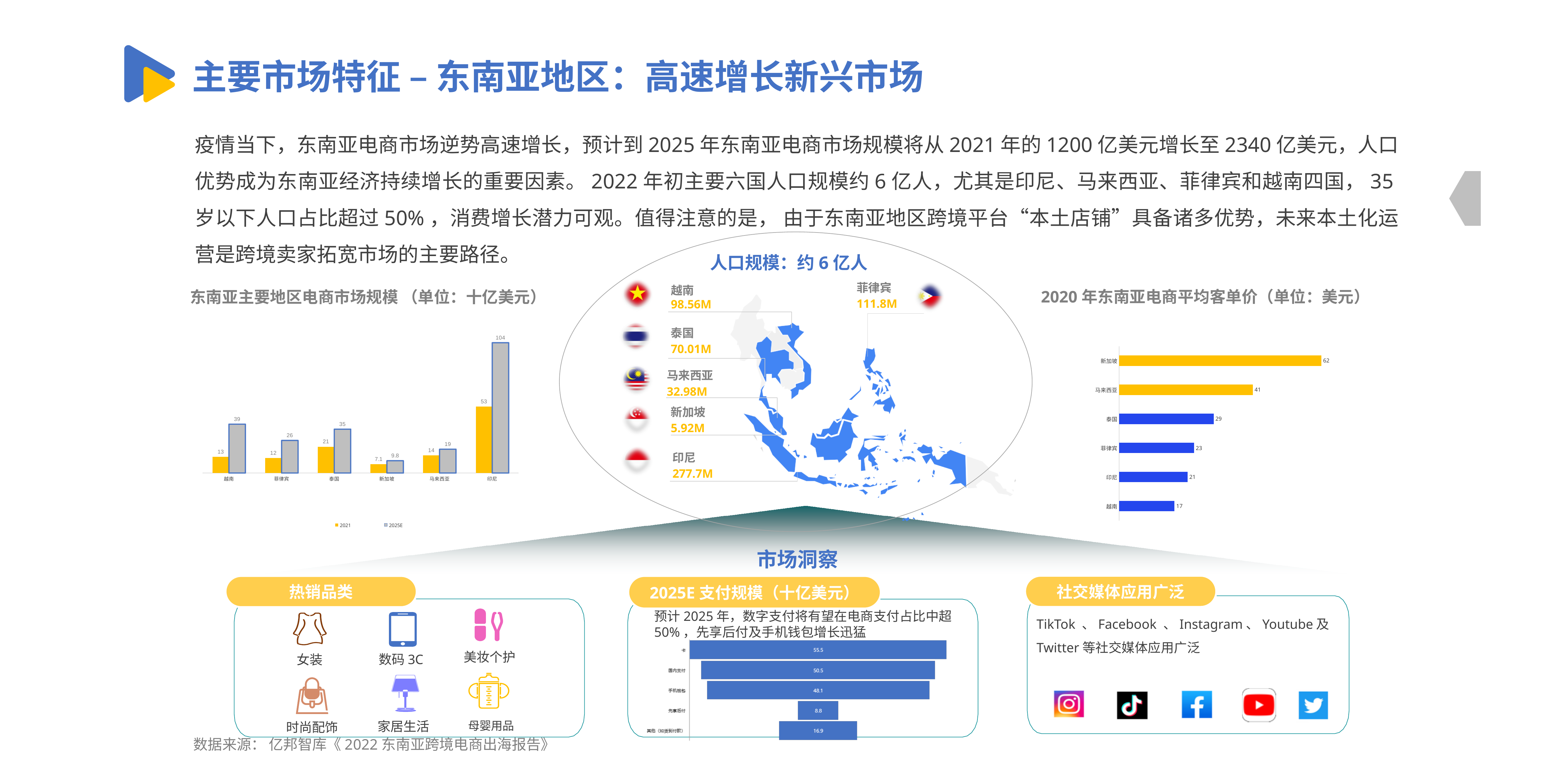
In the chart under 2025E 支付规模（十亿美元）, which category has the lowest value? 先享后付 In the chart titled 2020 年东南亚电商平均客单价, which is larger, the value for 泰国 or the value for 菲律宾? 泰国 In the chart titled 东南亚主要地区电商市场规模, how many countries are shown on the x axis? 6 In the chart titled 东南亚主要地区电商市场规模, what is the 2025E value for 印尼? 104 In the chart titled 2020 年东南亚电商平均客单价, what is the value for 马来西亚? 41 In the chart titled 东南亚主要地区电商市场规模, what is the difference between the 2025E and 2021 values for 越南? 26 In the chart titled 东南亚主要地区电商市场规模, what is the 2021 value for 新加坡? 7.1 In the chart titled 东南亚主要地区电商市场规模, which country has the lowest 2025E value? 新加坡 In the chart titled 东南亚主要地区电商市场规模, how many series does the legend list? 2 What kind of chart is the chart titled 2020 年东南亚电商平均客单价? bar chart In the chart titled 2020 年东南亚电商平均客单价, which country has the highest value? 新加坡 In the chart under 2025E 支付规模（十亿美元）, what is the value for 手机钱包? 48.1